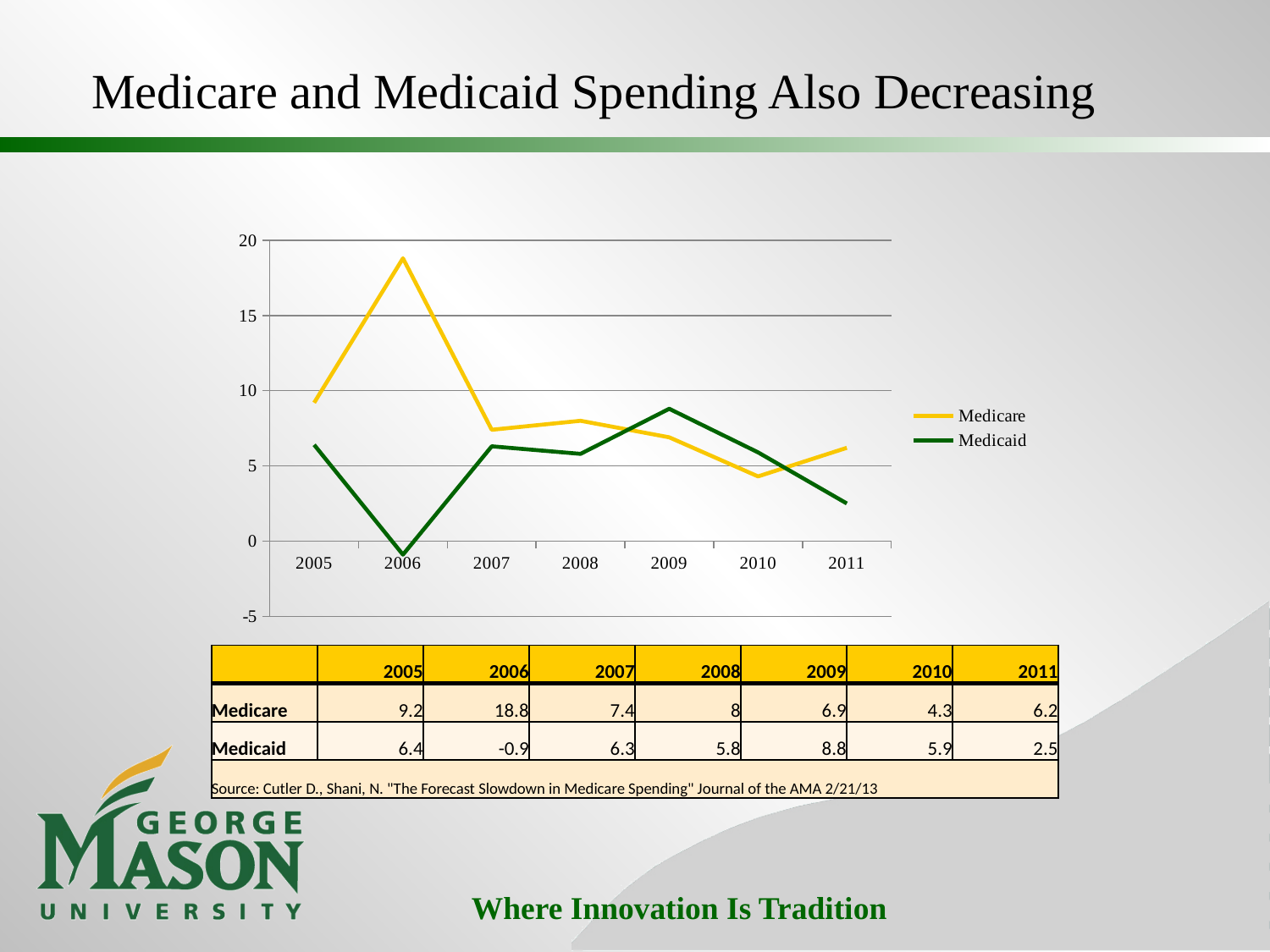
Which is larger in 2009, Medicare or Medicaid? Medicaid What is the Medicaid value for 2009? 8.8 What is the difference between the Medicare and Medicaid values in 2006? 19.7 What is the Medicare value for 2006? 18.8 Is the Medicare value for 2005 greater or less than 5? greater What is the Medicaid value for 2006? -0.9 What kind of chart is shown? line chart In which year is the Medicare series highest? 2006 Which colour is used for the Medicaid line? green How many years are plotted on the x axis? 7 How many series does the legend list? 2 In which year is the Medicaid series lowest? 2006